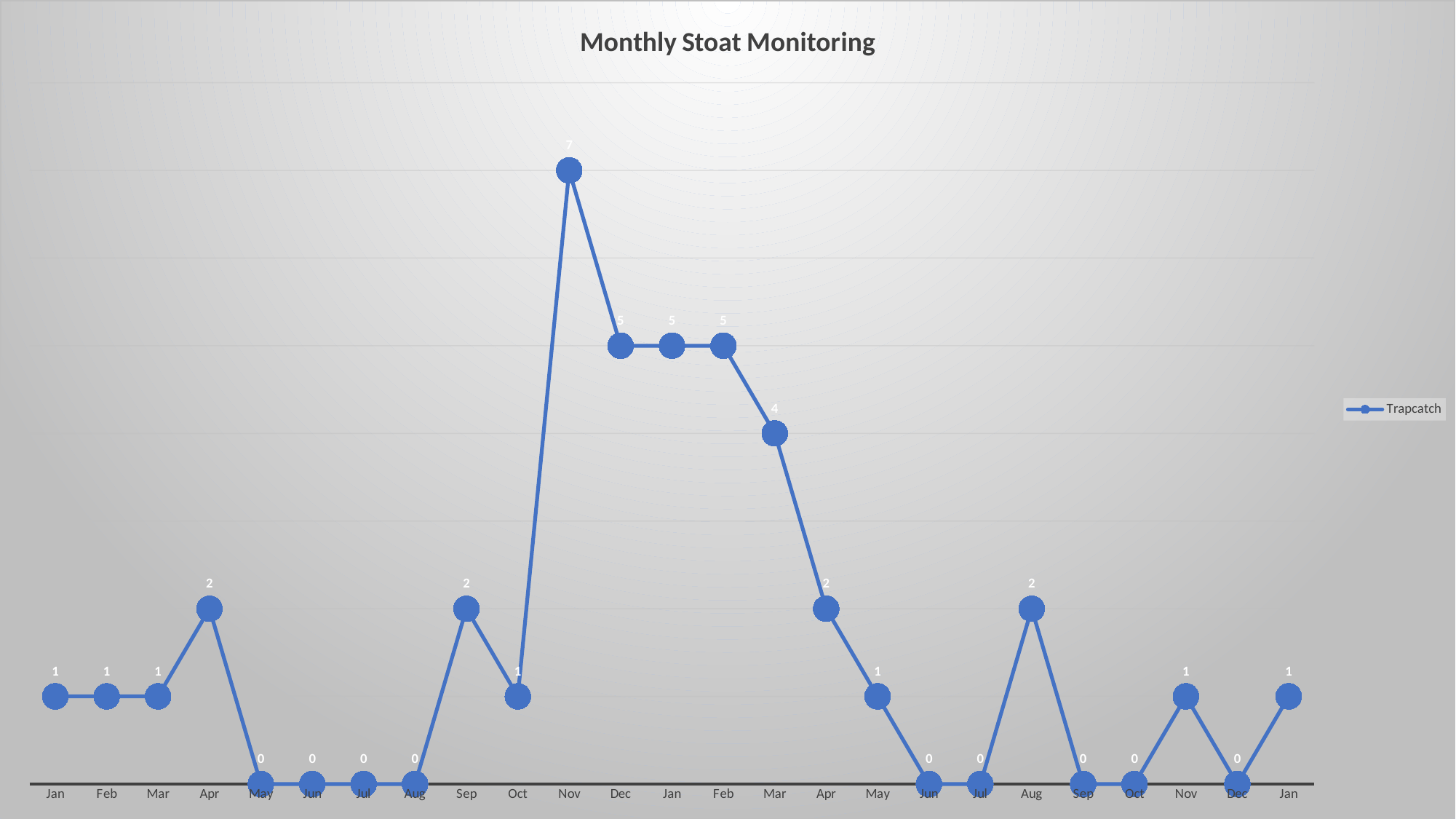
What is the difference between the Trapcatch value for the first Nov and the Dec immediately after it? 2 How many data points are plotted along the x axis? 25 What is the Trapcatch value for the first Nov on the x axis? 7 Which month has the highest Trapcatch value? Nov (the first Nov) What is the Trapcatch value for the second Mar on the x axis? 4 What is the Trapcatch value for the first Apr on the x axis? 2 How many series does the legend list? 1 What kind of chart is shown on the slide? line chart What is the title of the chart? Monthly Stoat Monitoring What series name does the legend show? Trapcatch What is the Trapcatch value for the final Jan at the right end of the x axis? 1 Which has the larger Trapcatch value, the first Sep or the first Oct? Sep